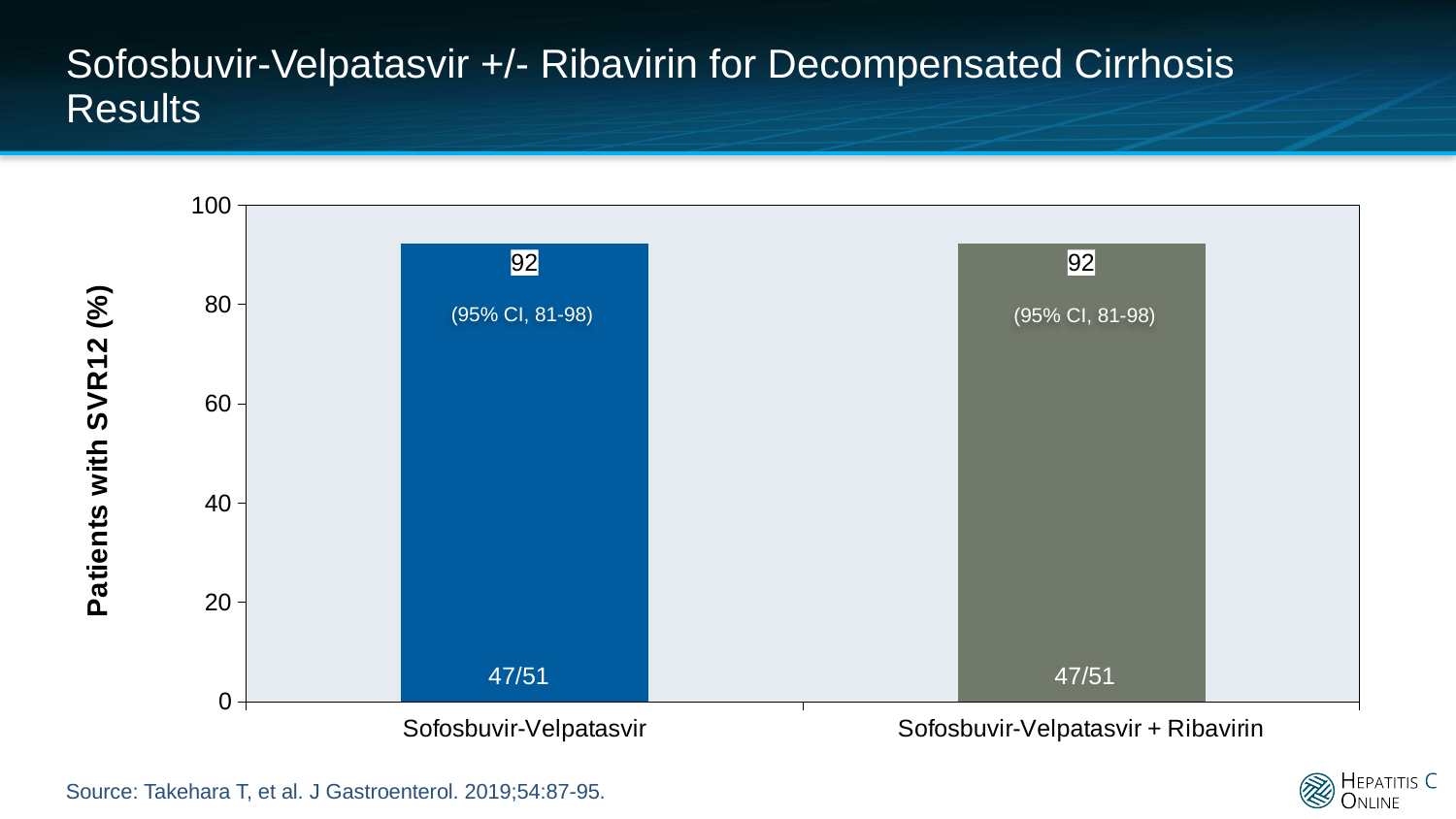
What kind of chart is shown on the slide? bar chart What is the 95% confidence interval shown for the Sofosbuvir-Velpatasvir bar? 81-98 What is the label of the y axis? Patients with SVR12 (%) What fraction of patients achieved SVR12 in the Sofosbuvir-Velpatasvir group? 47/51 How many treatment groups are shown on the chart? 2 Is the SVR12 value for Sofosbuvir-Velpatasvir + Ribavirin greater or less than 100? less Is the SVR12 value for Sofosbuvir-Velpatasvir greater or less than 80? greater What is the SVR12 rate for Sofosbuvir-Velpatasvir? 92 What is the difference in SVR12 rate between the Sofosbuvir-Velpatasvir + Ribavirin group and the Sofosbuvir-Velpatasvir group? 0 What is the SVR12 rate for Sofosbuvir-Velpatasvir + Ribavirin? 92 What fraction of patients achieved SVR12 in the Sofosbuvir-Velpatasvir + Ribavirin group? 47/51 What is the maximum value shown on the y axis? 100